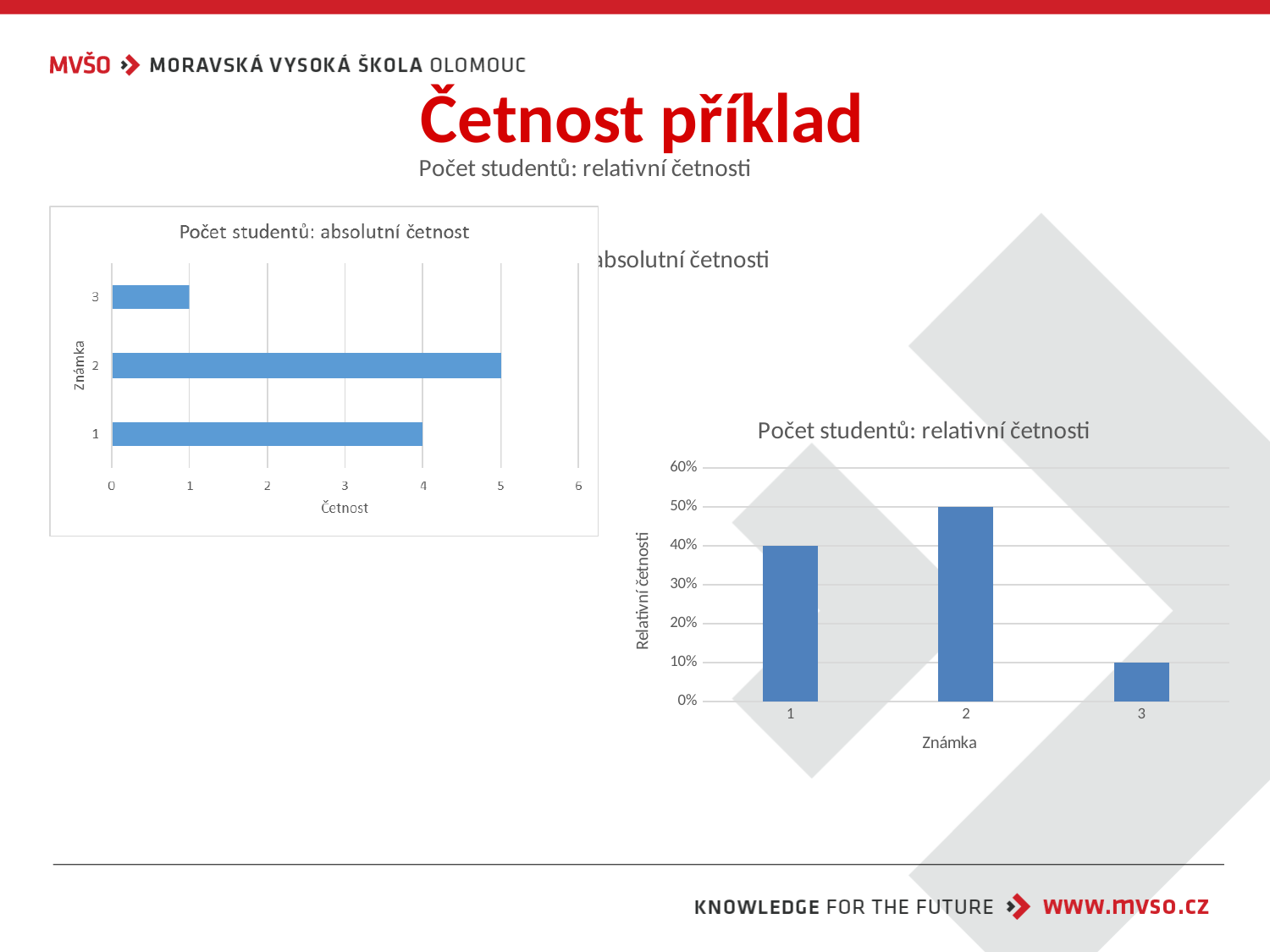
In the chart titled "Počet studentů: relativní četnosti", what is the label of the y axis? Relativní četnosti In the chart titled "Počet studentů: absolutní četnost", what is the value for známka 2? 5 In the chart titled "Počet studentů: relativní četnosti", which známka has the highest relative frequency? 2 In the chart titled "Počet studentů: relativní četnosti", is the value for známka 2 larger than the value for známka 1? yes In the chart titled "Počet studentů: relativní četnosti", what is the value for známka 1? 40% In the chart titled "Počet studentů: absolutní četnost", which známka has the highest četnost? 2 In the chart titled "Počet studentů: absolutní četnost", which známka has the lowest četnost? 3 In the chart titled "Počet studentů: absolutní četnost", what is the difference between the values for známka 2 and známka 3? 4 In the chart titled "Počet studentů: relativní četnosti", what is the value for známka 3? 10% In the chart titled "Počet studentů: absolutní četnost", what is the value for známka 1? 4 In the chart titled "Počet studentů: relativní četnosti", how many categories are shown on the x axis? 3 In the chart titled "Počet studentů: absolutní četnost", what kind of chart is shown? bar chart